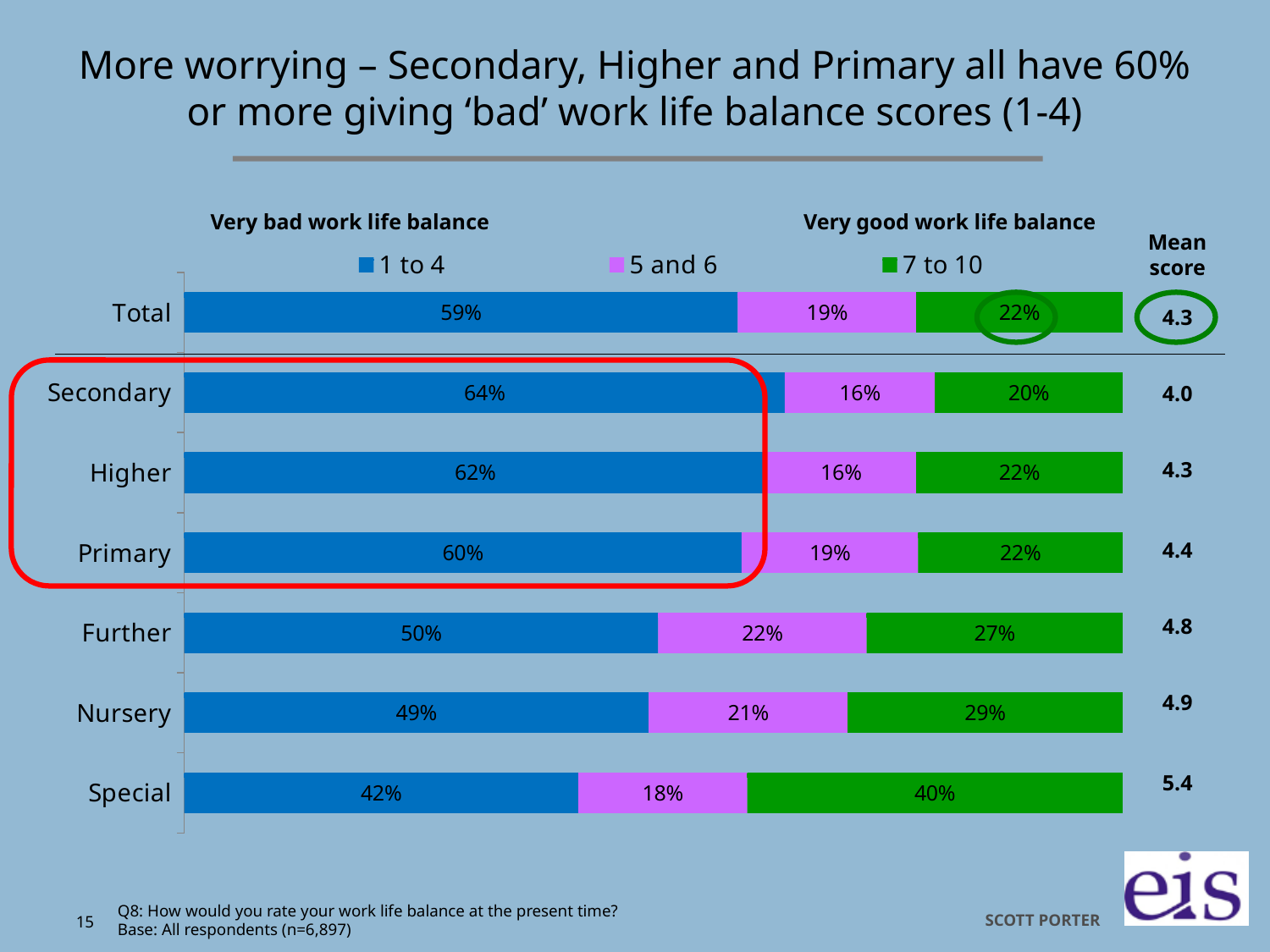
What percentage of Secondary respondents gave a score of 1 to 4? 64% What kind of chart is shown on the slide? Stacked bar chart What is the total of the Nursery bar? 99% Which is larger: the '7 to 10' value for Nursery or for Further? Nursery How many categories are shown on the chart? 7 What is the '5 and 6' value for Further? 22% Which category has the highest '1 to 4' percentage? Secondary What is the difference between the '1 to 4' percentages for Secondary and Special? 22% What percentage of Special respondents gave a score of 7 to 10? 40% What is the mean score shown for Special? 5.4 Which category has the lowest '7 to 10' percentage? Secondary How many series does the legend list? 3